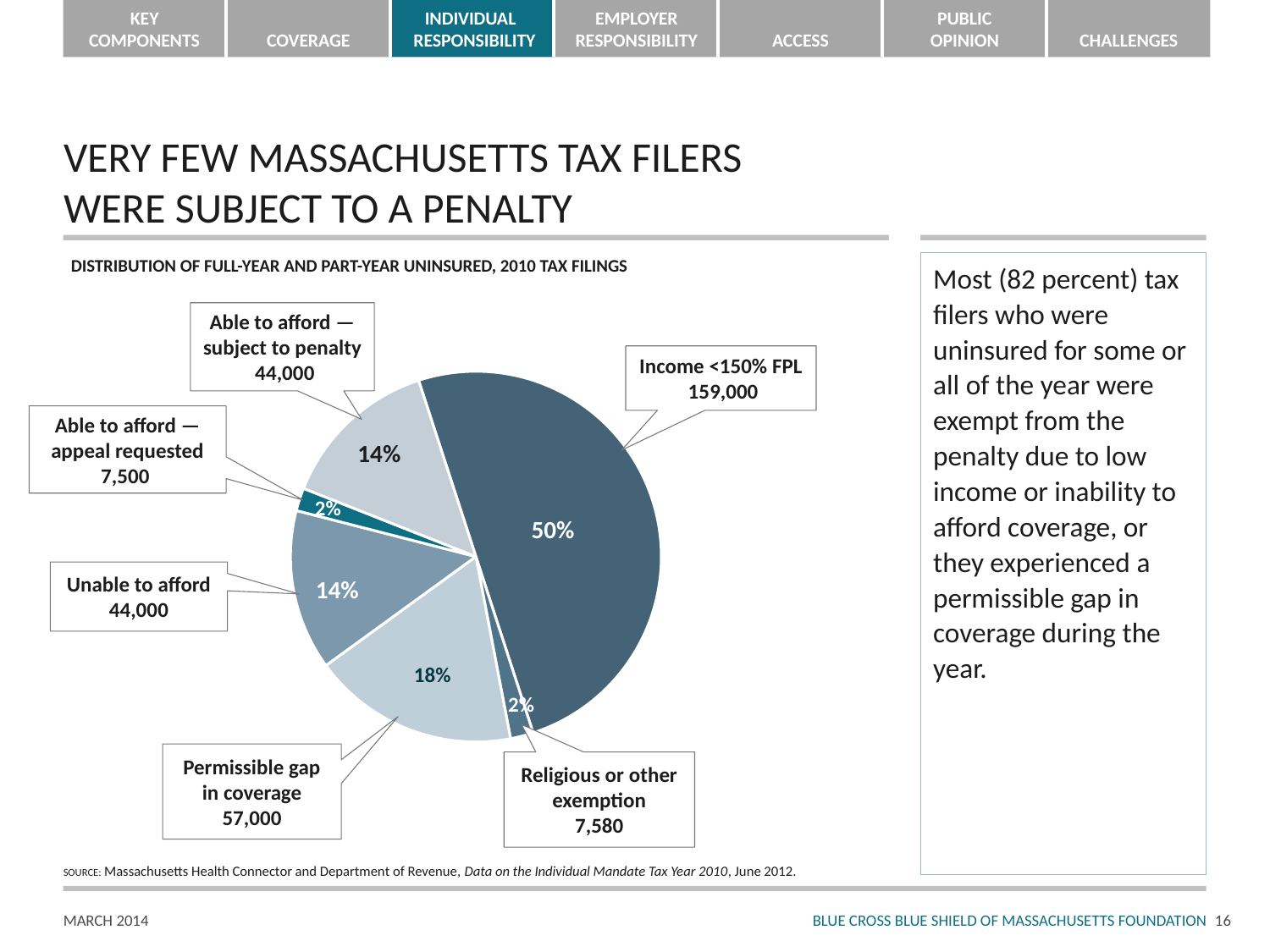
What percentage of the pie is 'Permissible gap in coverage'? 18% What is the difference in tax filers between 'Income <150% FPL' and 'Permissible gap in coverage'? 102,000 What type of chart is shown on the slide? pie chart Which category has the smallest number of tax filers? Able to afford — appeal requested What is the title of the chart? DISTRIBUTION OF FULL-YEAR AND PART-YEAR UNINSURED, 2010 TAX FILINGS Which category has the largest slice of the pie? Income <150% FPL How many slices does the pie chart have? 6 How many tax filers are in the 'Permissible gap in coverage' category? 57,000 Which has more tax filers: 'Unable to afford' or 'Able to afford — appeal requested'? Unable to afford How many tax filers are in the 'Religious or other exemption' category? 7,580 How many tax filers are in the 'Income <150% FPL' category? 159,000 What share of the pie does 'Income <150% FPL' represent? 50%